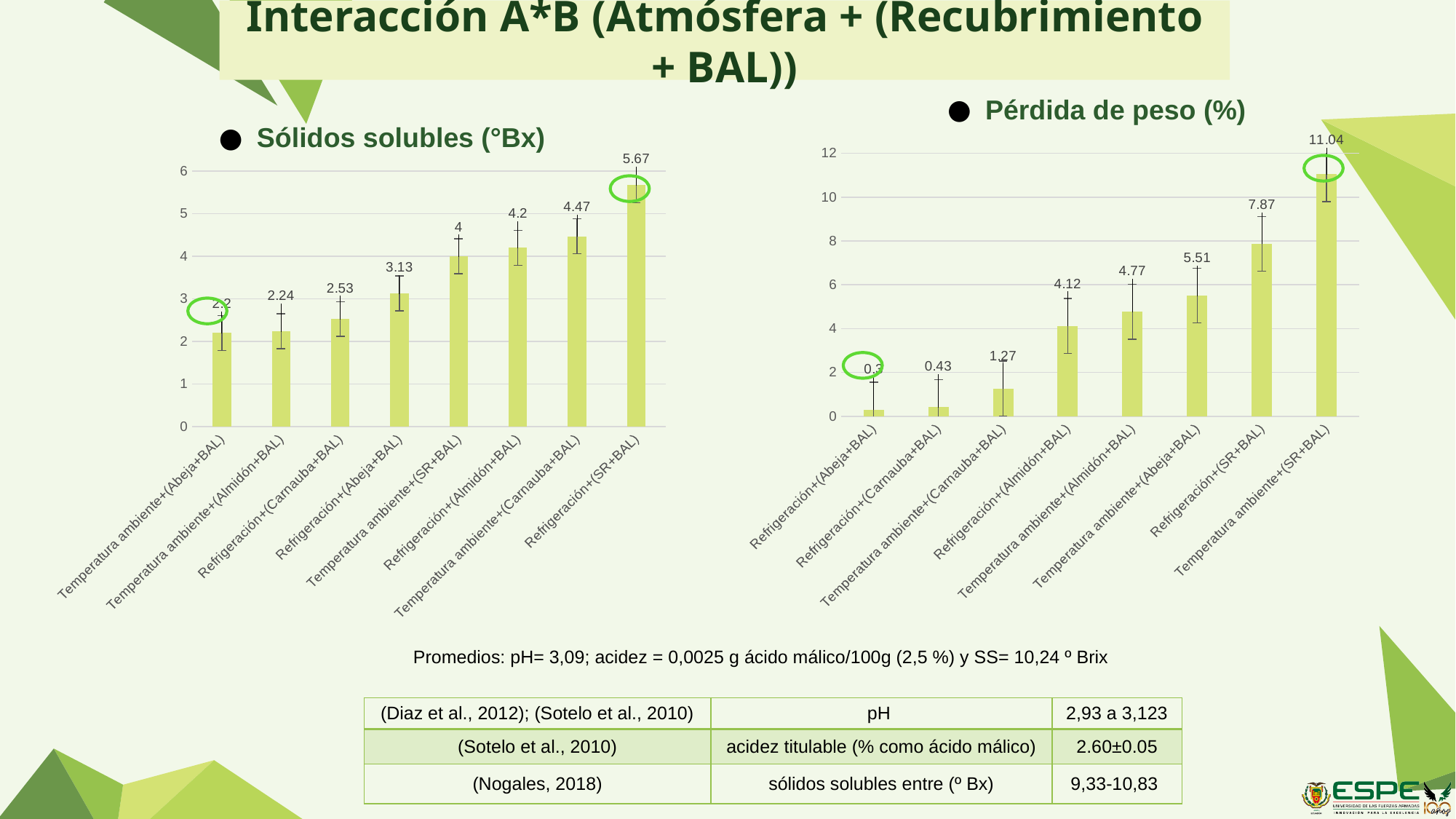
In the 'Pérdida de peso (%)' chart, is the value for Refrigeración+(Almidón+BAL) greater or less than 6? less In the 'Pérdida de peso (%)' chart, what is the value for Temperatura ambiente+(SR+BAL)? 11.04 What kind of chart is the 'Pérdida de peso (%)' chart? bar chart In the 'Sólidos solubles (°Bx)' chart, what is the value for Refrigeración+(SR+BAL)? 5.67 In the 'Sólidos solubles (°Bx)' chart, do the values rise or fall from left to right? rise In the 'Pérdida de peso (%)' chart, what is the difference between Temperatura ambiente+(SR+BAL) and Refrigeración+(SR+BAL)? 3.17 In the 'Sólidos solubles (°Bx)' chart, which category has the highest value? Refrigeración+(SR+BAL) In the 'Sólidos solubles (°Bx)' chart, what is the difference between Temperatura ambiente+(Carnauba+BAL) and Refrigeración+(Almidón+BAL)? 0.27 In the 'Pérdida de peso (%)' chart, what is the value for Temperatura ambiente+(Abeja+BAL)? 5.51 In the 'Sólidos solubles (°Bx)' chart, how many categories are plotted? 8 In the 'Sólidos solubles (°Bx)' chart, what is the value for Refrigeración+(Abeja+BAL)? 3.13 In the 'Pérdida de peso (%)' chart, which is larger: Refrigeración+(SR+BAL) or Temperatura ambiente+(Almidón+BAL)? Refrigeración+(SR+BAL)